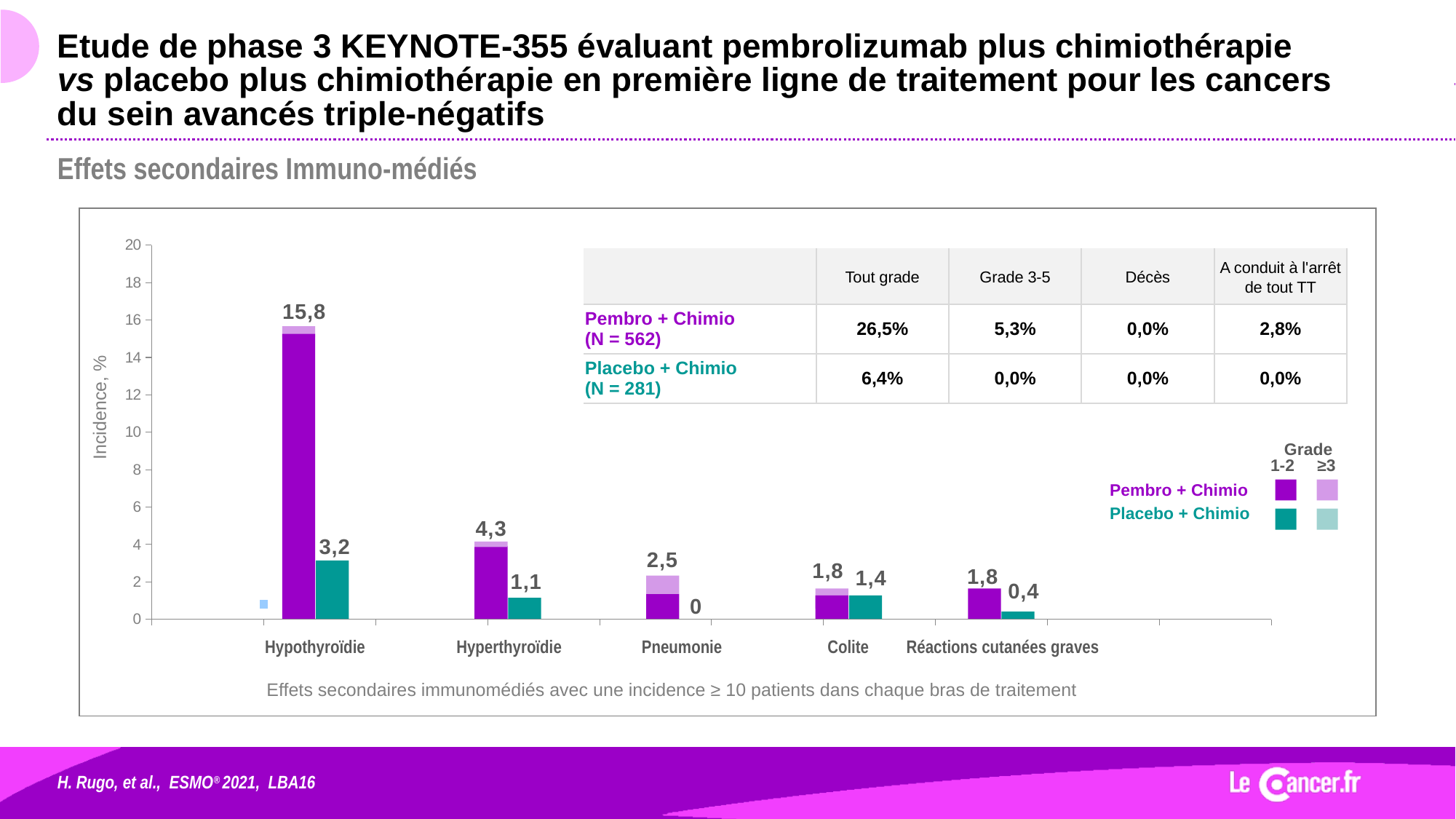
What is the difference between the Pembro + Chimio and Placebo + Chimio incidences for Hypothyroïdie? 12,6 What is the incidence for Placebo + Chimio in the Hyperthyroïdie category? 1,1 What is the label of the y axis of the chart? Incidence, % For Colite, which arm has the higher incidence, Pembro + Chimio or Placebo + Chimio? Pembro + Chimio What is the incidence for Placebo + Chimio in the Réactions cutanées graves category? 0,4 How many adverse event categories are shown on the x axis of the chart? 5 What is the incidence for Pembro + Chimio in the Hypothyroïdie category? 15,8 What is the difference between the Pembro + Chimio and Placebo + Chimio incidences for Hyperthyroïdie? 3,2 Is the Pembro + Chimio incidence for Hypothyroïdie greater or less than 10? greater What is the incidence for Placebo + Chimio in the Pneumonie category? 0 Which category has the highest incidence for Pembro + Chimio? Hypothyroïdie Which category has the lowest incidence for Placebo + Chimio? Pneumonie